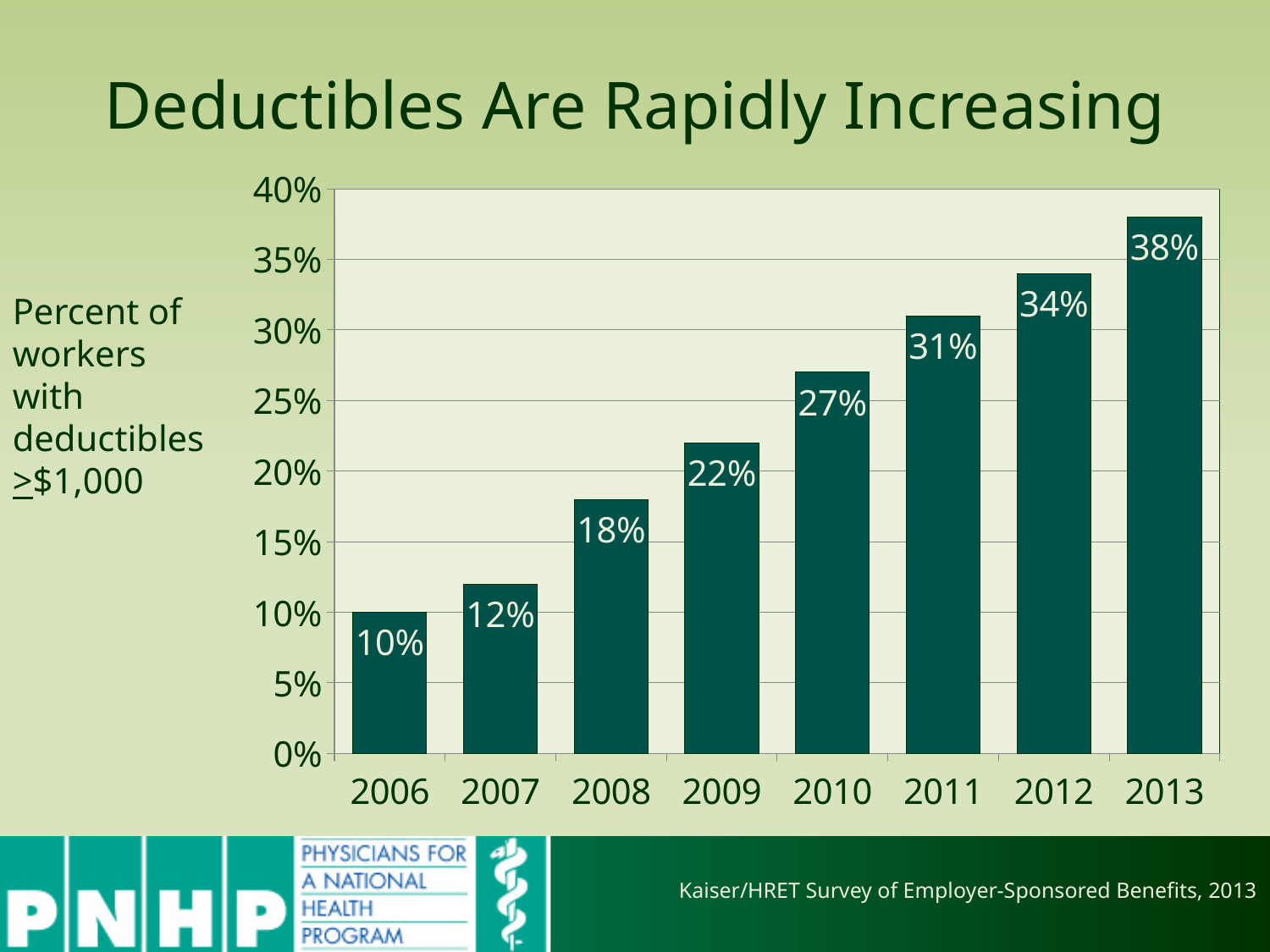
What is the difference between the values for 2009 and 2008? 4 percentage points What is the value shown for 2010? 27% Which is larger, the value for 2011 or the value for 2012? 2012 Which year has the highest percent of workers with deductibles of $1,000 or more? 2013 What percent of workers had deductibles of $1,000 or more in 2006? 10% What kind of chart is shown on the slide? Bar chart What is the value shown for 2013? 38% Which year has the lowest value on the chart? 2006 Do the values rise or fall from 2006 to 2013? Rise How many years are shown on the x axis? 8 Is the value for 2009 greater or less than 20%? greater By how many percentage points did the value increase from 2006 to 2013? 28 percentage points